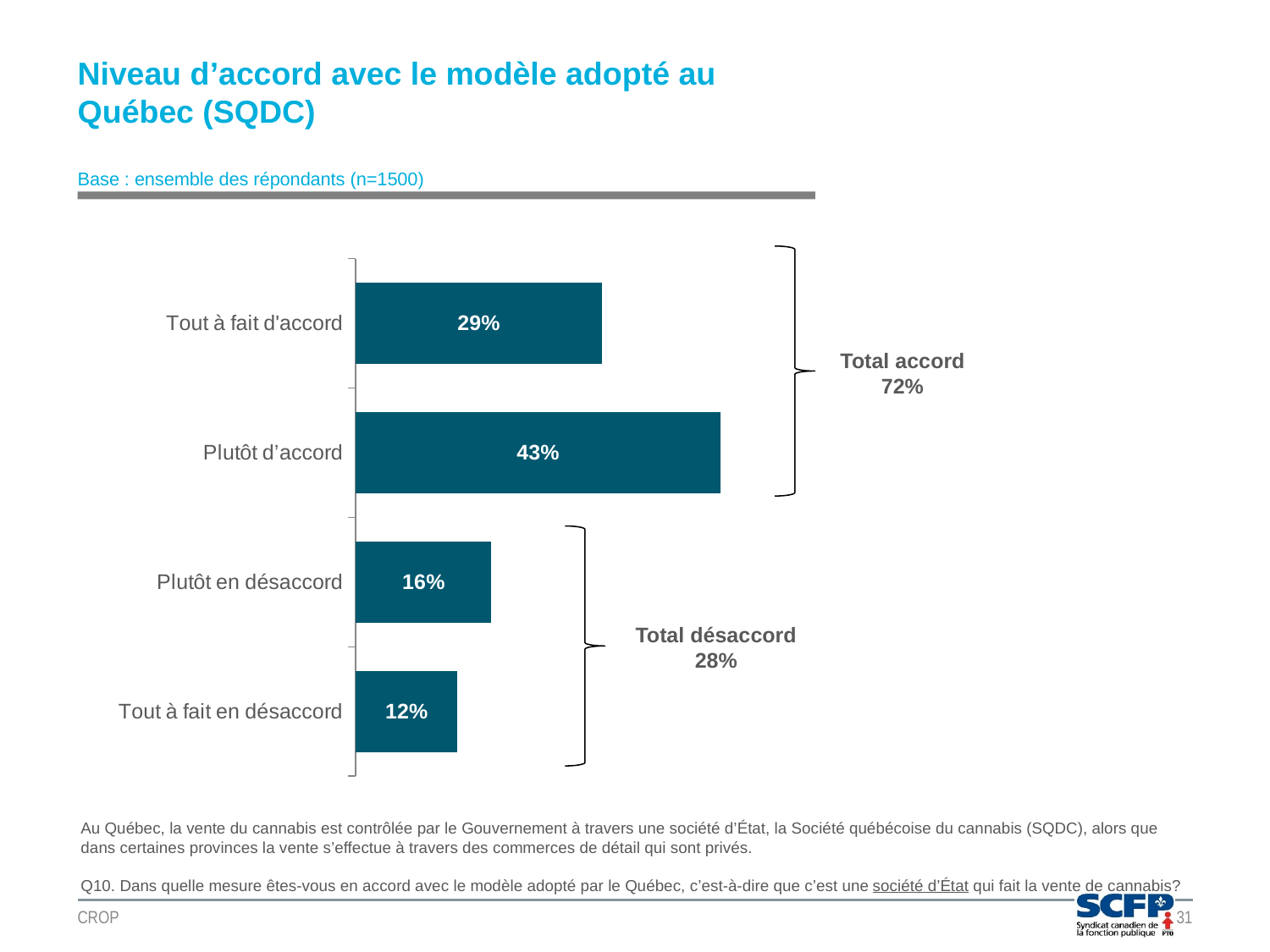
What is the value for "Tout à fait en désaccord"? 12% Which category has the highest value? Plutôt d'accord What is the difference between the values for "Plutôt d'accord" and "Tout à fait d'accord"? 14% Which is larger, the value for "Plutôt en désaccord" or the value for "Tout à fait en désaccord"? Plutôt en désaccord What is the value for "Plutôt en désaccord"? 16% What is the value for "Tout à fait d'accord"? 29% How many categories are shown in the chart? 4 What is the "Total désaccord" value shown next to the chart? 28% Which category has the lowest value? Tout à fait en désaccord What is the value for "Plutôt d'accord"? 43% What is the "Total accord" value shown next to the chart? 72% What kind of chart is shown on the slide? Bar chart